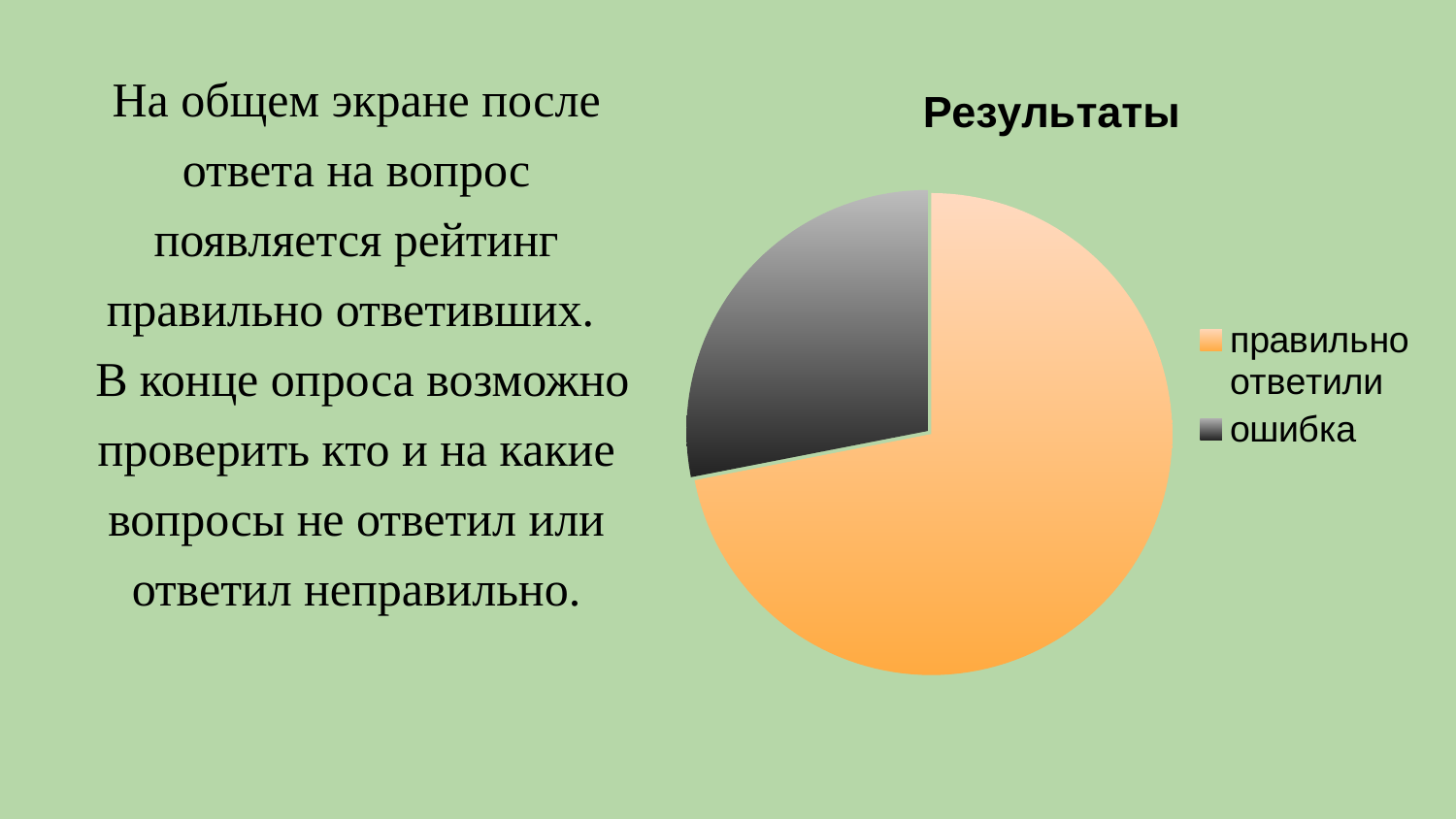
What is the title of the chart? Результаты How many slices does the pie chart have? 2 Which category has the smallest slice of the pie? ошибка Which category has the largest slice of the pie? правильно ответили Which slice is larger, "правильно ответили" or "ошибка"? правильно ответили How many entries does the chart legend list? 2 What colour is the "ошибка" slice in the pie chart? dark gray What kind of chart is shown on the slide? pie chart